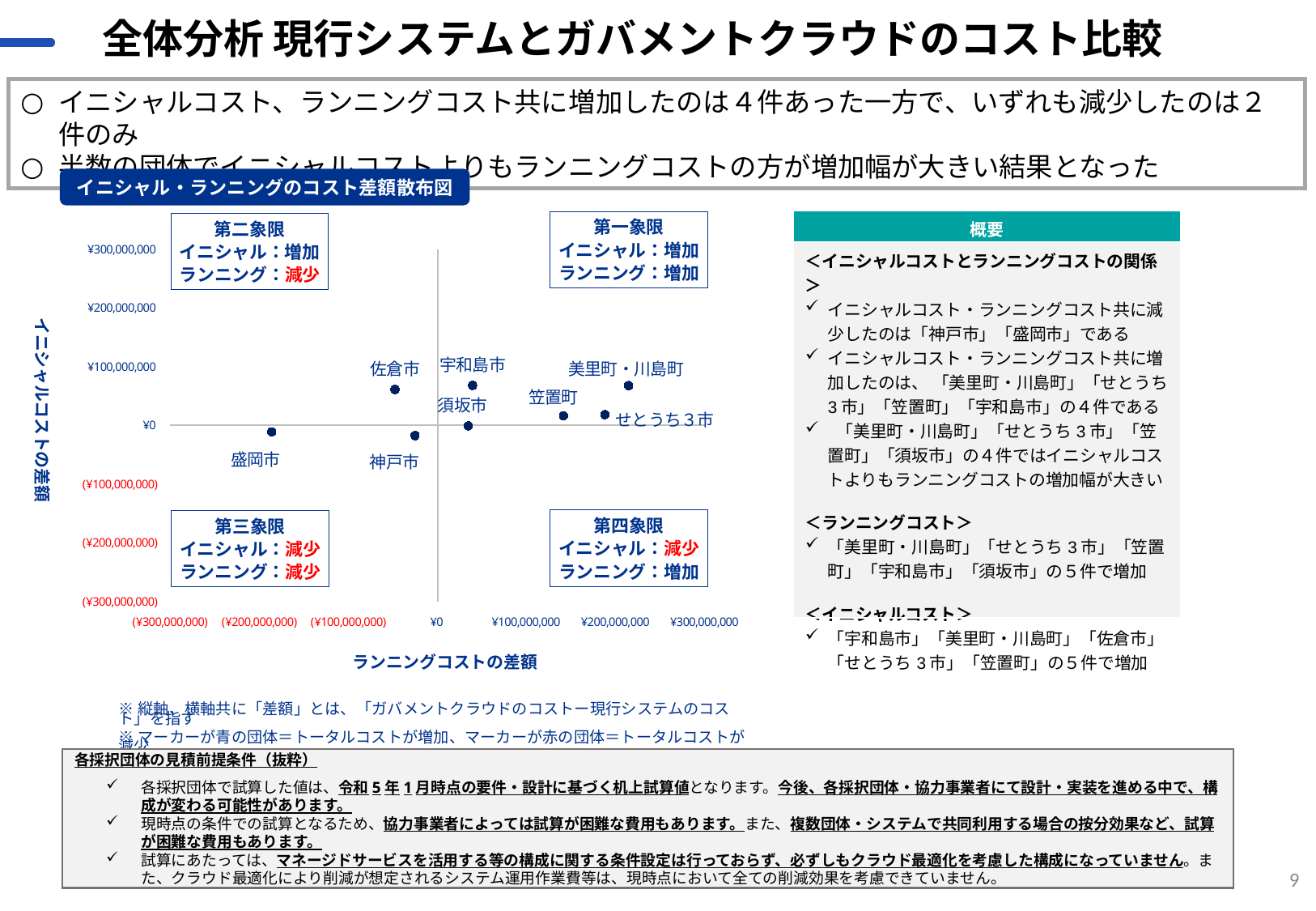
What is the label of the horizontal axis of the scatter chart? ランニングコストの差額 Is the running cost difference for 盛岡市 greater or less than (¥100,000,000)? less Is the running cost difference for せとうち３市 greater or less than ¥100,000,000? greater Which municipality has the lowest running cost difference (furthest left on the x axis)? 盛岡市 Is the running cost difference for 美里町・川島町 greater or less than ¥100,000,000? greater Which has the larger running cost difference, 美里町・川島町 or 笠置町? 美里町・川島町 How many municipalities (data points) are plotted in the scatter chart? 8 Which municipality has the highest running cost difference (furthest right on the x axis)? 美里町・川島町 Which has the larger initial cost difference, 佐倉市 or 神戸市? 佐倉市 What kind of chart is shown on the slide? Scatter chart What is the title of the scatter chart? イニシャル・ランニングのコスト差額散布図